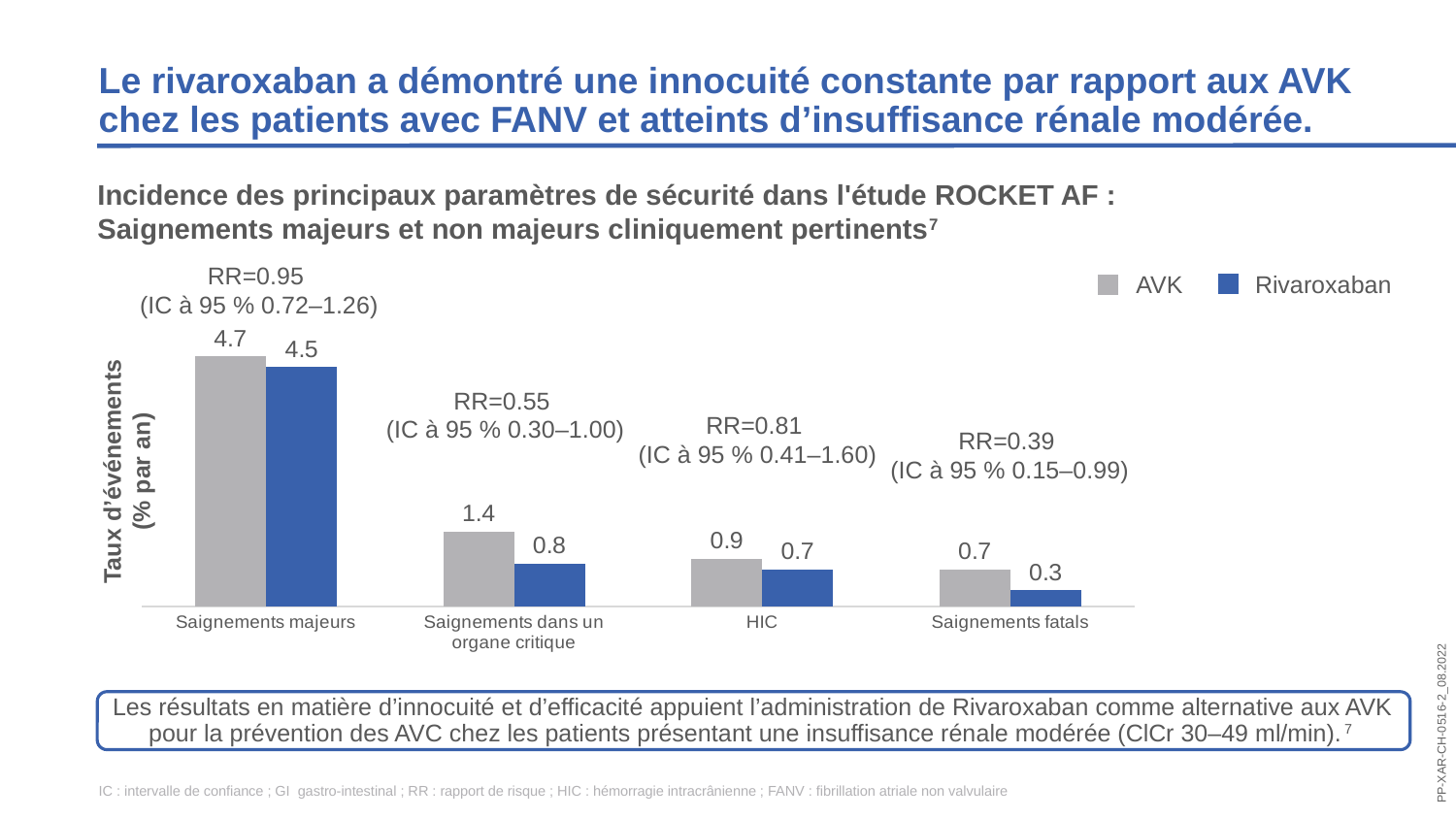
How many categories are shown on the x axis? 4 What is the difference between the AVK and Rivaroxaban values for Saignements dans un organe critique? 0.6 What is the RR shown above the Saignements fatals bars? RR=0.39 Which is larger for Saignements fatals, the AVK value or the Rivaroxaban value? AVK What is the AVK value for Saignements majeurs? 4.7 Which category has the lowest Rivaroxaban value? Saignements fatals What is the AVK value for HIC? 0.9 What is the Rivaroxaban value for Saignements fatals? 0.3 Which category has the highest AVK value? Saignements majeurs How many series does the legend list? 2 What kind of chart is shown? Bar chart What is the Rivaroxaban value for Saignements dans un organe critique? 0.8